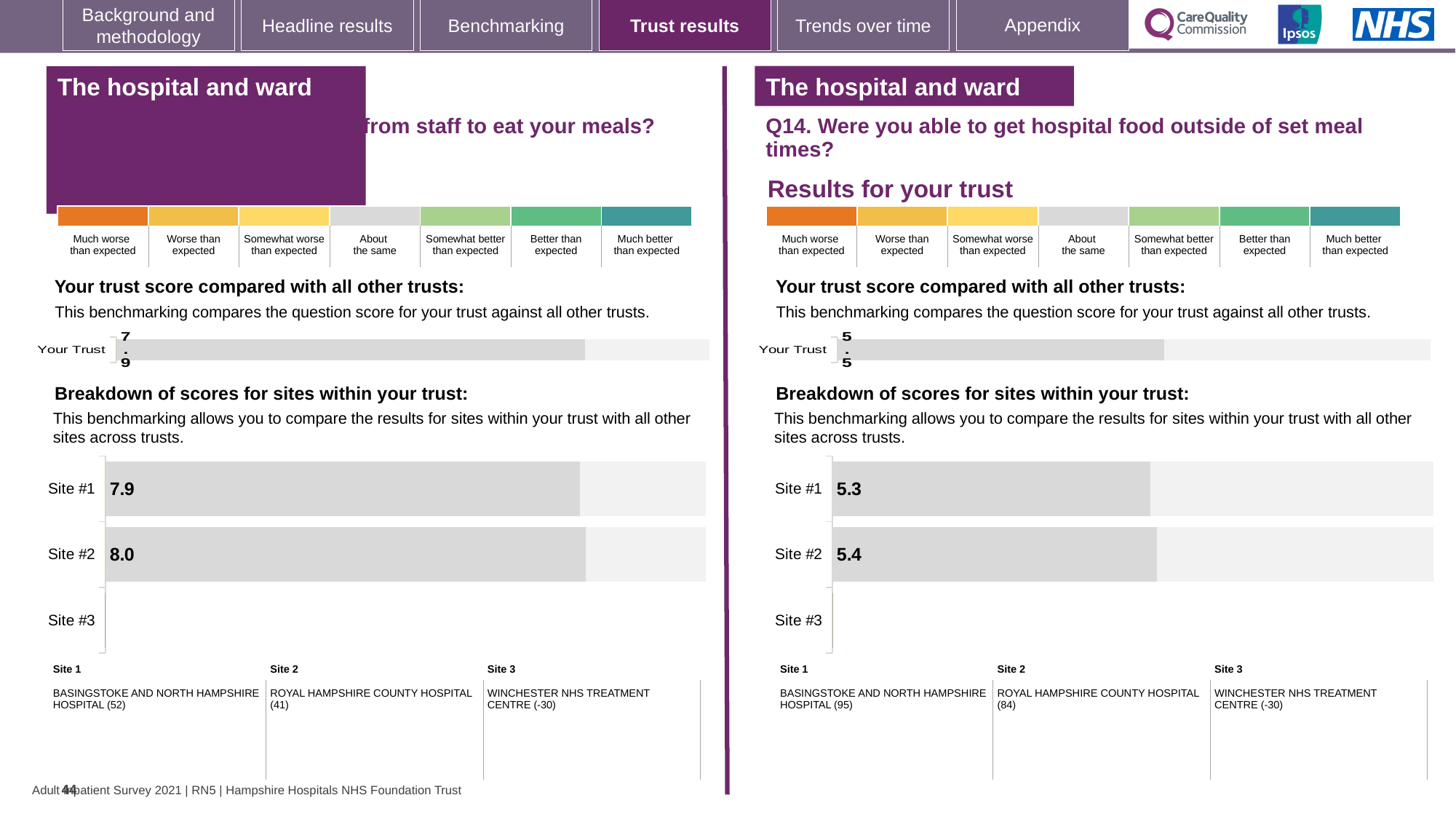
On the left-hand chart (help from staff to eat your meals), what is the score for Site #2? 8.0 On the right-hand chart (Q14), which site has no bar plotted? Site #3 How many site categories are listed on the site breakdown chart on the right-hand side (Q14)? 3 On the left-hand chart, what is the difference between the Site #2 score and the Site #1 score? 0.1 On the right-hand chart (Q14), what is the difference between the Site #2 score and the Site #1 score? 0.1 On the right-hand chart (Q14), which site has the higher score, Site #1 or Site #2? Site #2 On the right-hand chart (Q14), what is the 'Your Trust' score? 5.5 On the right-hand chart (Q14, hospital food outside of set meal times), what is the score for Site #1? 5.3 On the left-hand chart (help from staff to eat your meals), what is the score for Site #1? 7.9 On the right-hand chart (Q14), what is the score for Site #2? 5.4 On the left-hand chart (help from staff to eat your meals), what is the 'Your Trust' score? 7.9 What type of chart is used for the breakdown of scores for sites on the right-hand side (Q14)? Bar chart